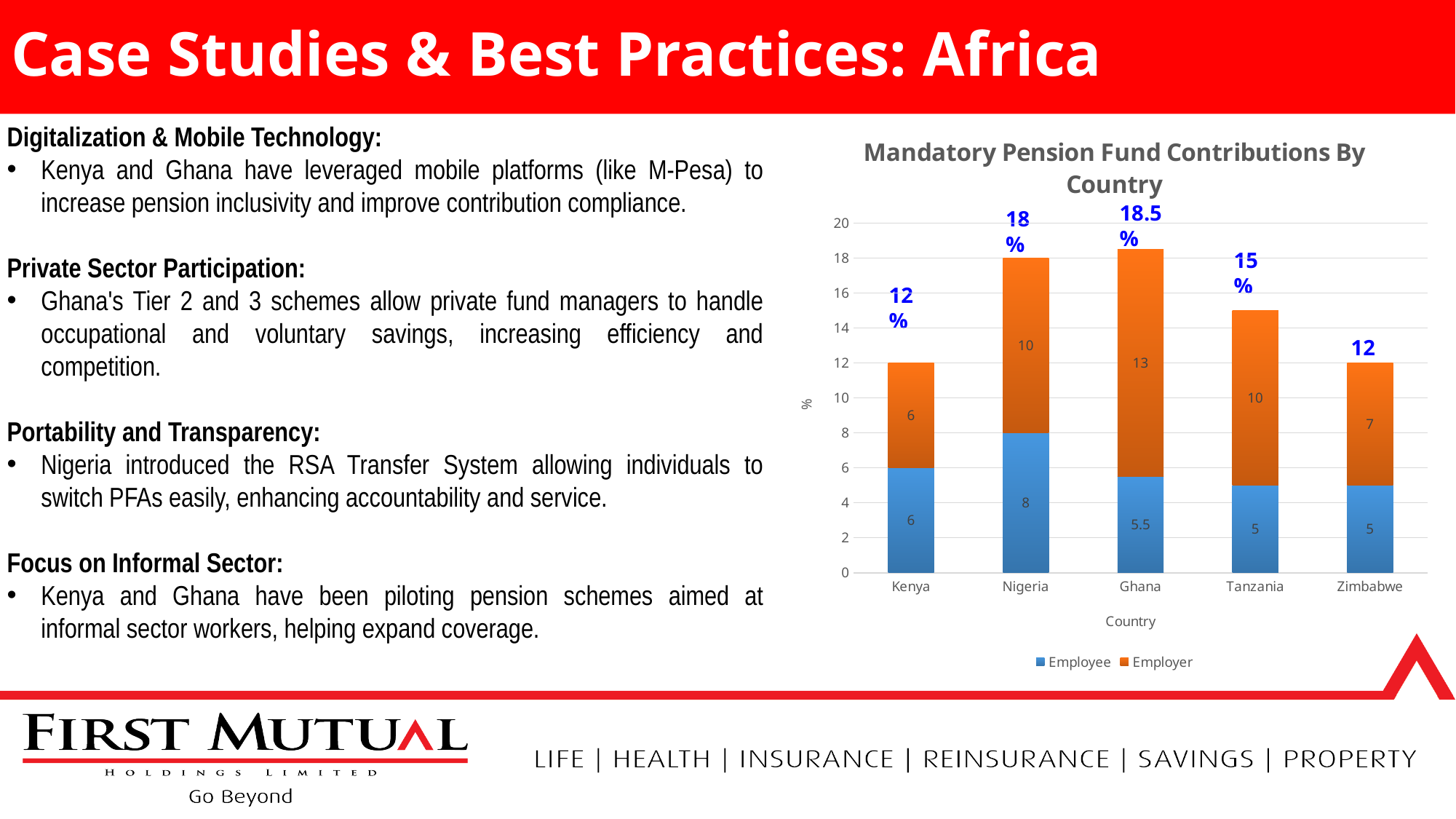
What is the Employer contribution for Zimbabwe? 7 What is the Employee contribution for Nigeria? 8 What is the Employer contribution for Ghana? 13 Which country has the highest total mandatory pension fund contribution? Ghana What is the Employee contribution for Ghana? 5.5 Which country has the lowest Employee contribution? Tanzania and Zimbabwe What is the total mandatory pension fund contribution for Tanzania? 15% Which is larger, the Employer contribution for Nigeria or for Zimbabwe? Nigeria How many series does the legend list? 2 What type of chart is shown on the slide? Stacked bar chart How many countries are shown in the chart? 5 What is the difference between the Employer contributions of Ghana and Kenya? 7